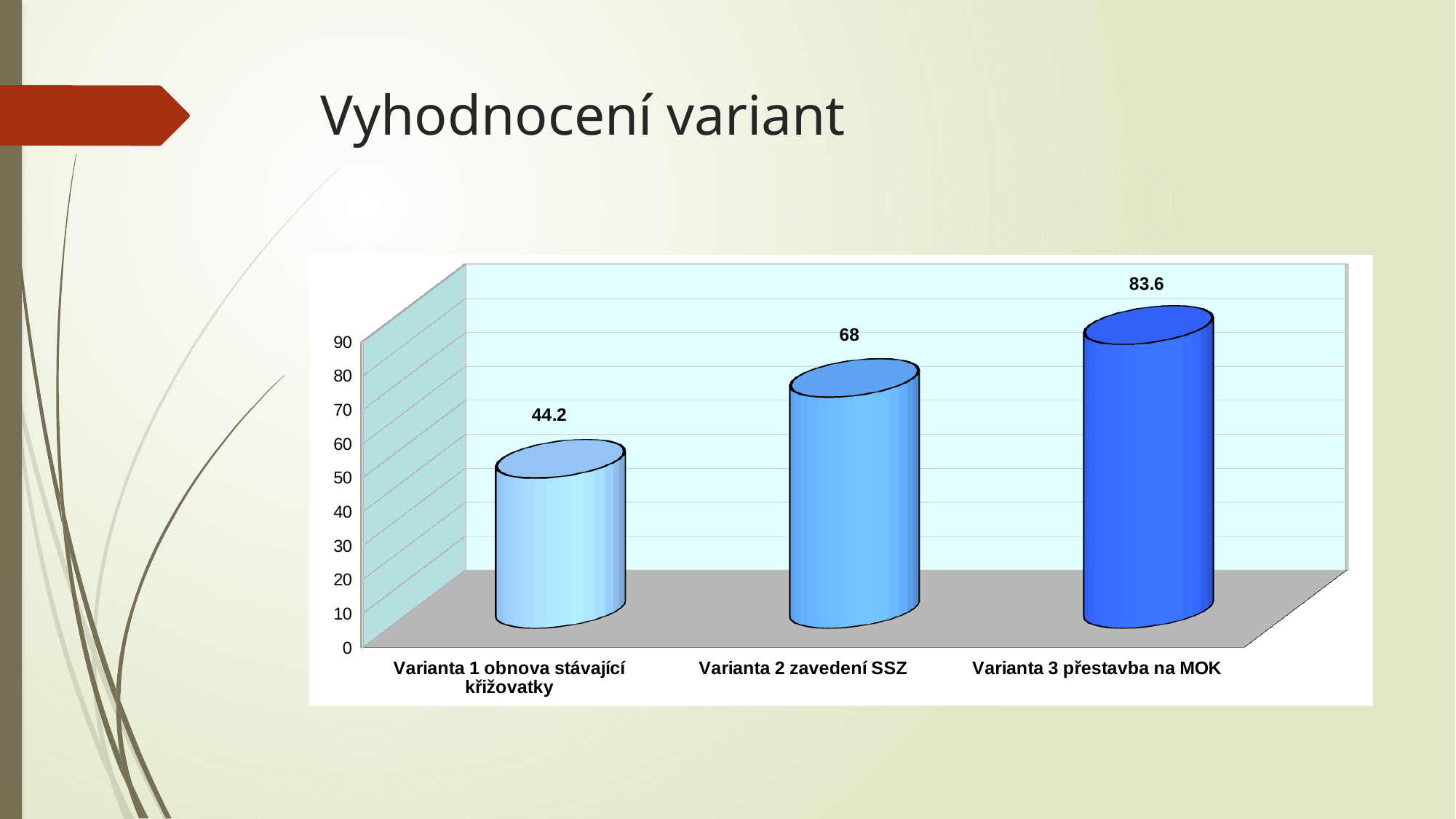
What is the value for Varianta 1 obnova stávající křižovatky? 44.2 How many categories are shown on the chart? 3 What kind of chart is shown on the slide? bar chart Which category has the highest value? Varianta 3 přestavba na MOK Is the value for Varianta 2 zavedení SSZ greater or less than 60? greater Which is larger, the value for Varianta 2 zavedení SSZ or Varianta 3 přestavba na MOK? Varianta 3 přestavba na MOK What is the difference between the values for Varianta 3 přestavba na MOK and Varianta 1 obnova stávající křižovatky? 39.4 Which category has the lowest value? Varianta 1 obnova stávající křižovatky Do the values rise or fall from left to right along the x axis? rise What is the value for Varianta 2 zavedení SSZ? 68 What is the value for Varianta 3 přestavba na MOK? 83.6 What is the difference between the values for Varianta 2 zavedení SSZ and Varianta 1 obnova stávající křižovatky? 23.8